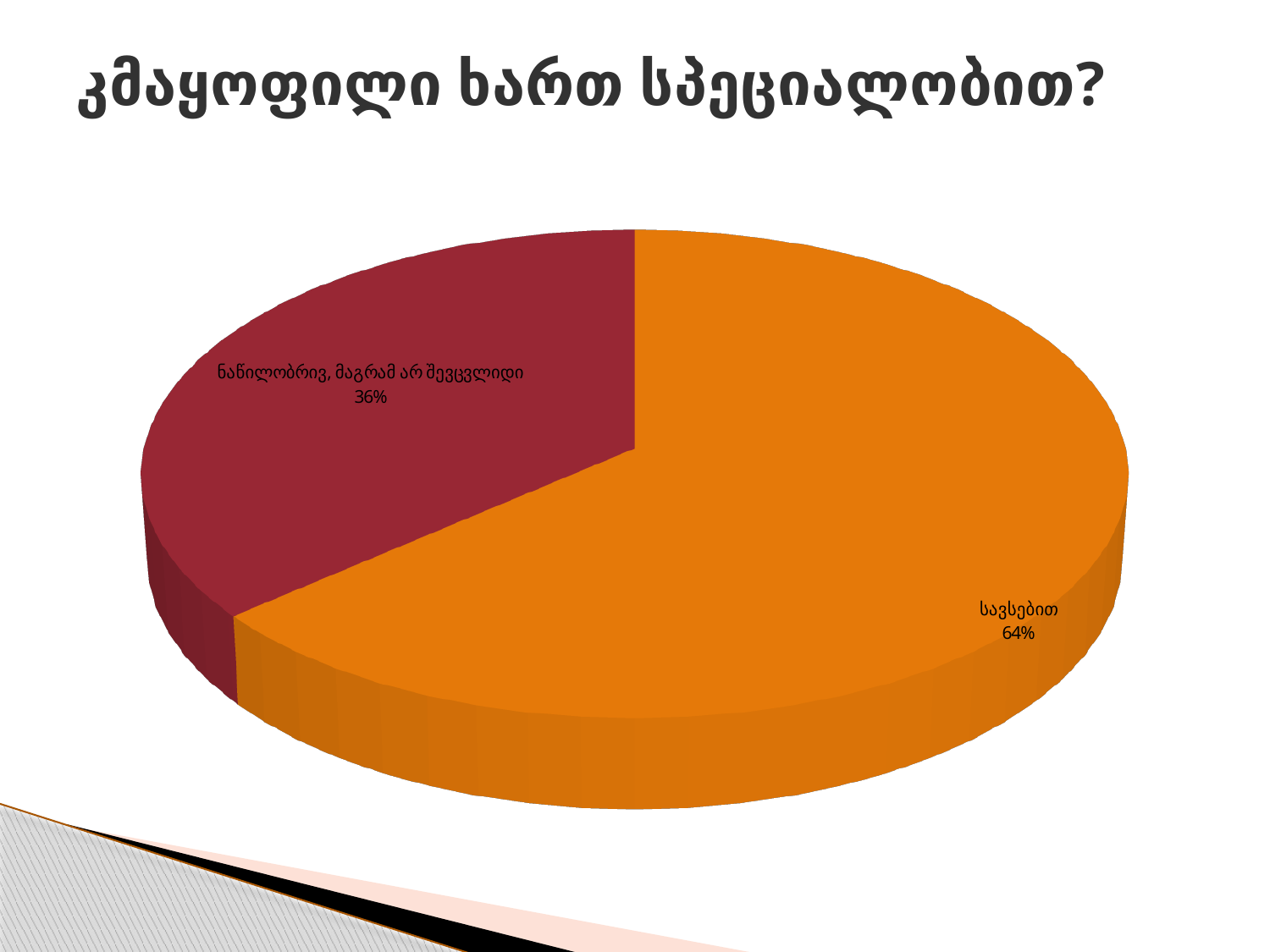
What is the difference in percentage points between the "სავსებით" slice and the "ნაწილობრივ, მაგრამ არ შევცვლიდი" slice? 28 Which slice of the pie is the smallest? ნაწილობრივ, მაგრამ არ შევცვლიდი What share of the pie does the "სავსებით" slice represent? 64% How many slices does the pie chart have? 2 What is the title of the slide above the pie chart? კმაყოფილი ხართ სპეციალობით? What percentage is shown for the slice labelled "ნაწილობრივ, მაგრამ არ შევცვლიდი"? 36% What percentage is shown for the slice labelled "სავსებით"? 64% Which is larger: the share for "სავსებით" or the share for "ნაწილობრივ, მაგრამ არ შევცვლიდი"? სავსებით What colour is the "სავსებით" slice of the pie? orange Which slice of the pie is the largest? სავსებით What kind of chart is shown on the slide? pie chart